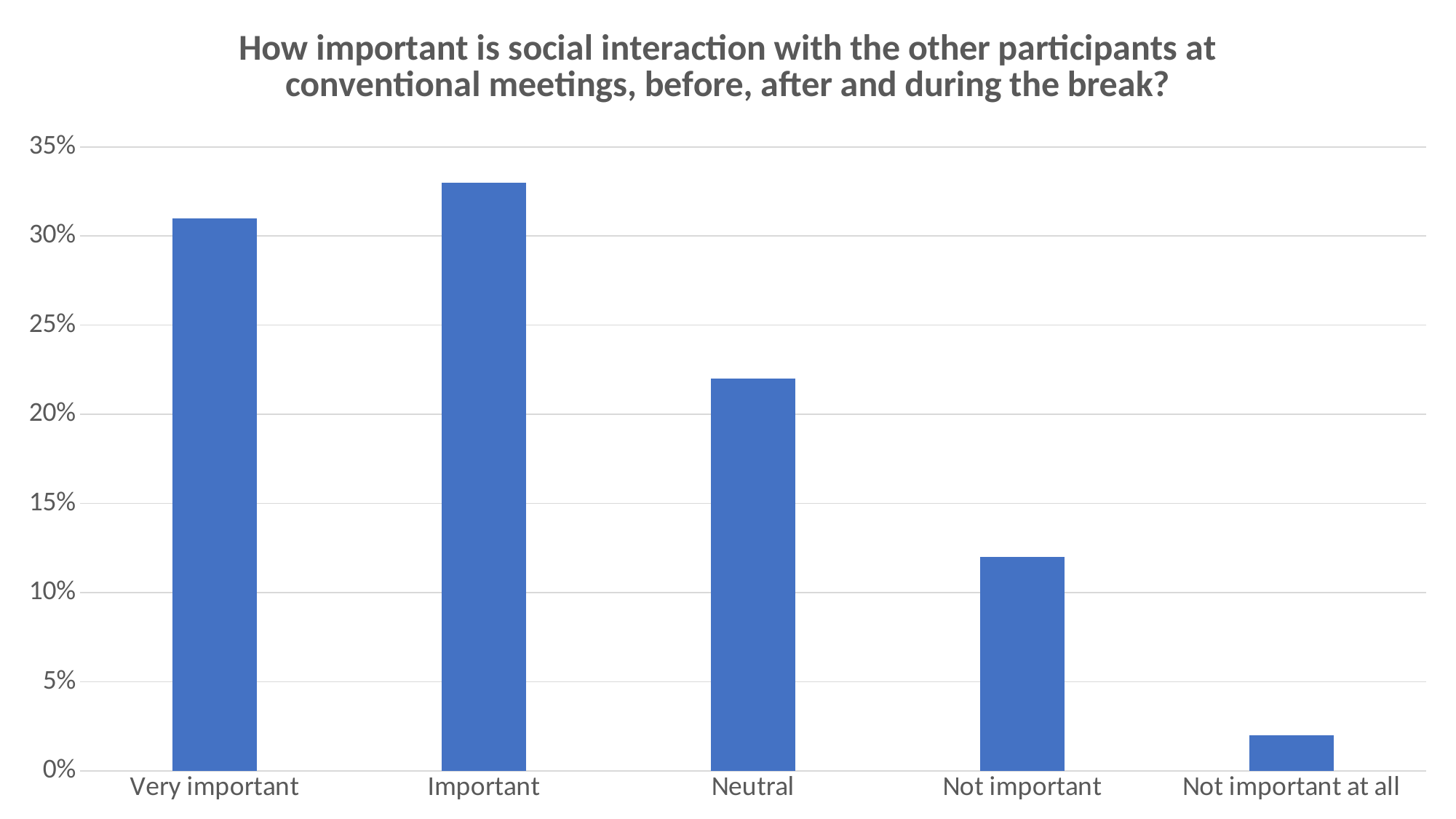
Which is larger, the value for Very important or the value for Neutral? Very important Which is larger, the value for Neutral or the value for Not important? Neutral Is the value for Not important at all greater or less than 5%? less Moving from Important to Not important at all along the x axis, do the values rise or fall? fall What is the title of the chart? How important is social interaction with the other participants at conventional meetings, before, after and during the break? What kind of chart is shown on the slide? bar chart Which category has the highest value? Important Is the value for Important greater or less than 30%? greater Is the value for Neutral greater or less than 25%? less How many categories are shown on the x axis? 5 Which category has the lowest value? Not important at all